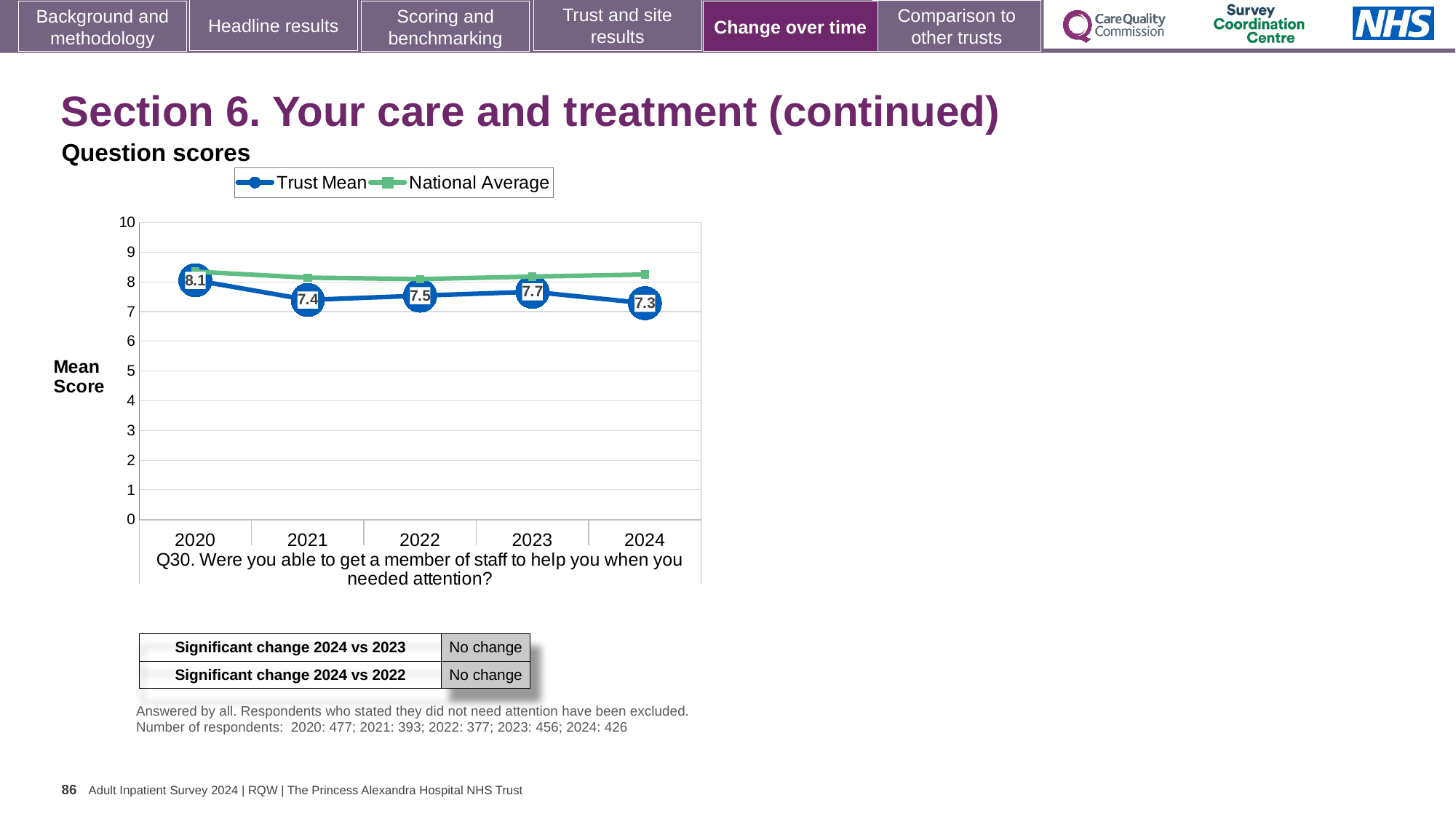
How many years are plotted on the x axis? 5 Which is larger, the Trust Mean score for 2023 or for 2021? 2023 In which year is the Trust Mean score lowest? 2024 Does the Trust Mean score rise or fall from 2020 to 2021? Fall In which year is the Trust Mean score highest? 2020 What is the Trust Mean score for 2022? 7.5 What is the difference between the Trust Mean score in 2020 and in 2024? 0.8 What is the Trust Mean score for 2024? 7.3 How many series does the legend list? 2 Is the National Average value for 2020 greater or less than 8? greater What kind of chart is shown? Line chart What is the Trust Mean score for 2020? 8.1